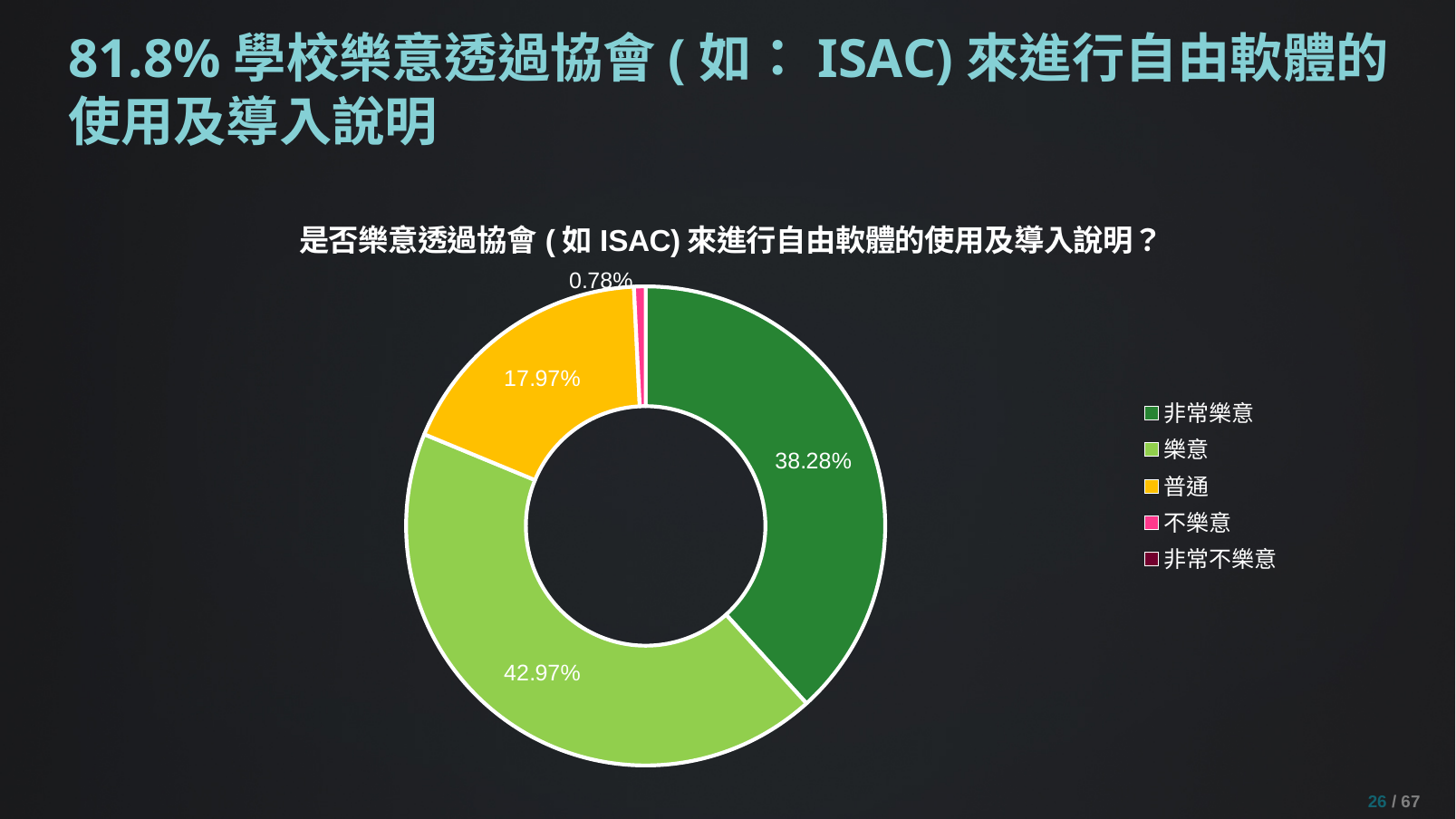
What is the difference between the shares for 樂意 and 非常樂意? 4.69% How many response categories does the legend list? 5 Which labelled response category has the smallest share of the chart? 不樂意 Which response category has the largest share of the chart? 樂意 What percentage of schools answered 非常樂意? 38.28% What is the difference between the shares for 非常樂意 and 普通? 20.31% What kind of chart is shown on the slide? Doughnut (pie) chart What percentage of schools answered 樂意? 42.97% What colour is the 普通 slice in the chart? Yellow Which is larger, the share for 非常樂意 or the share for 普通? 非常樂意 What percentage of schools answered 普通? 17.97% What percentage of schools answered 不樂意? 0.78%